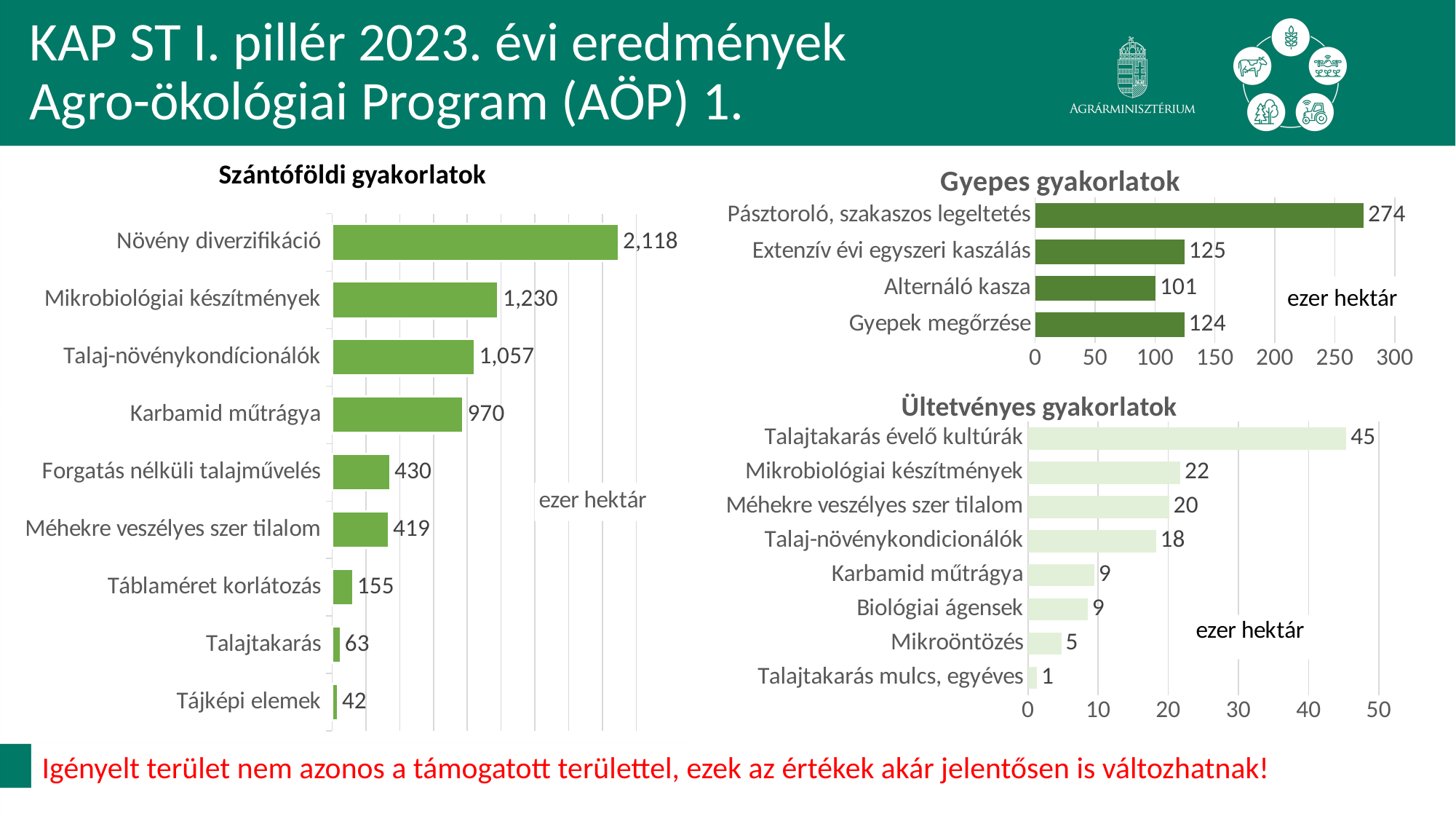
In the 'Szántóföldi gyakorlatok' chart, how many categories are shown? 9 In the 'Ültetvényes gyakorlatok' chart, how many categories are shown? 8 In the 'Szántóföldi gyakorlatok' chart, which category has the lowest value? Tájképi elemek In the 'Szántóföldi gyakorlatok' chart, what is the value for Növény diverzifikáció? 2,118 In the 'Ültetvényes gyakorlatok' chart, what is the value for Talajtakarás évelő kultúrák? 45 What type of chart is the 'Ültetvényes gyakorlatok' chart? Bar chart In the 'Ültetvényes gyakorlatok' chart, which category has the lowest value? Talajtakarás mulcs, egyéves In the 'Gyepes gyakorlatok' chart, which is larger: Extenzív évi egyszeri kaszálás or Gyepek megőrzése? Extenzív évi egyszeri kaszálás In the 'Gyepes gyakorlatok' chart, which category has the highest value? Pásztoroló, szakaszos legeltetés What unit label is shown on the 'Gyepes gyakorlatok' chart? ezer hektár In the 'Szántóföldi gyakorlatok' chart, what is the difference between Mikrobiológiai készítmények and Talaj-növénykondícionálók? 173 In the 'Gyepes gyakorlatok' chart, what is the value for Alternáló kasza? 101